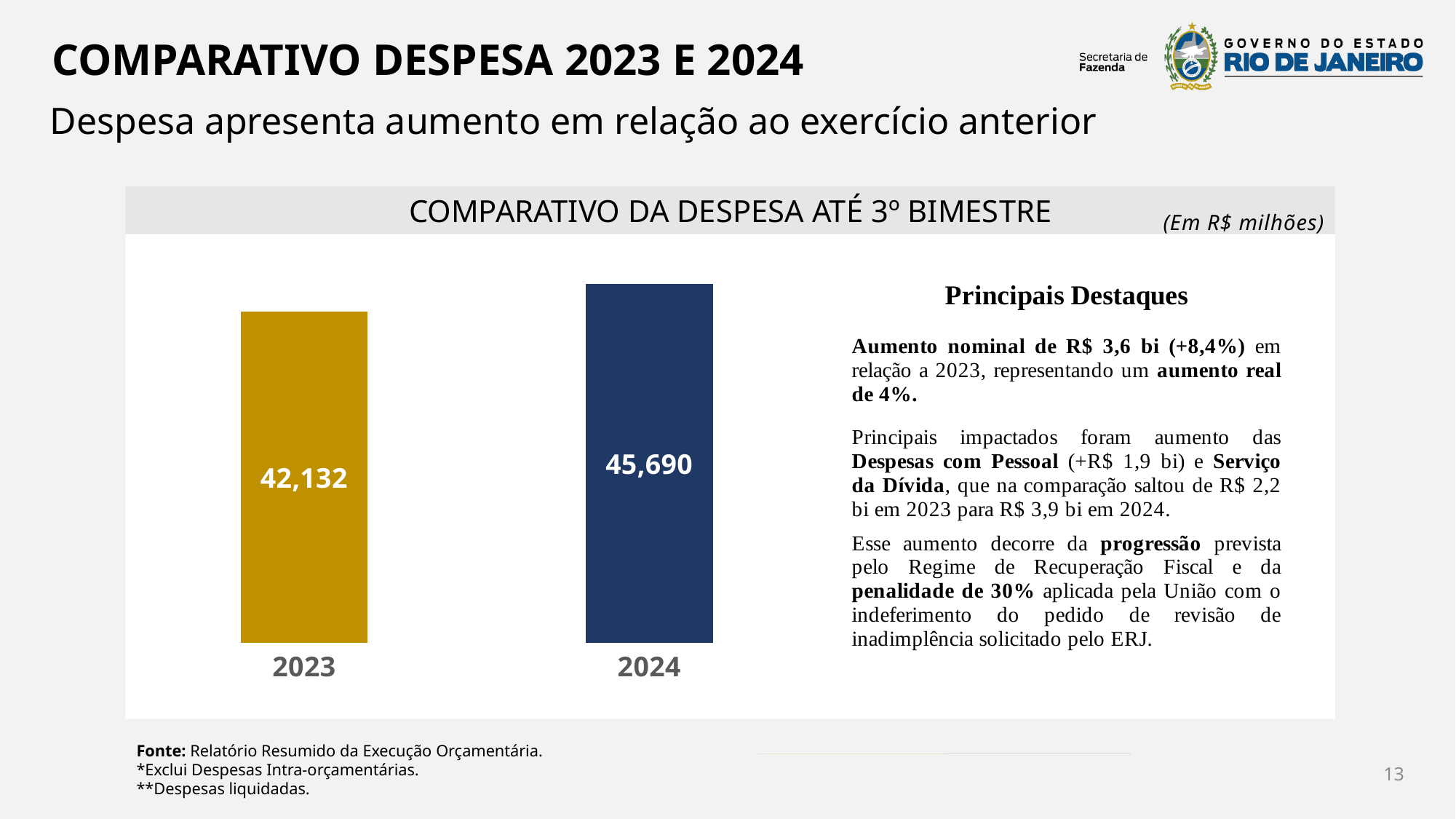
What is the value shown for 2023? 42,132 How many bars are plotted in the chart? 2 Is the value for 2024 larger or smaller than the value for 2023? larger Do the values rise or fall from 2023 to 2024? rise Which year has the higher expense value? 2024 What is the value shown for 2024? 45,690 What is the difference between the 2024 and 2023 values? 3,558 What type of chart is shown? bar chart In what unit are the chart values expressed? R$ milhões What is the title of the chart? COMPARATIVO DA DESPESA ATÉ 3º BIMESTRE Which year has the lower expense value? 2023